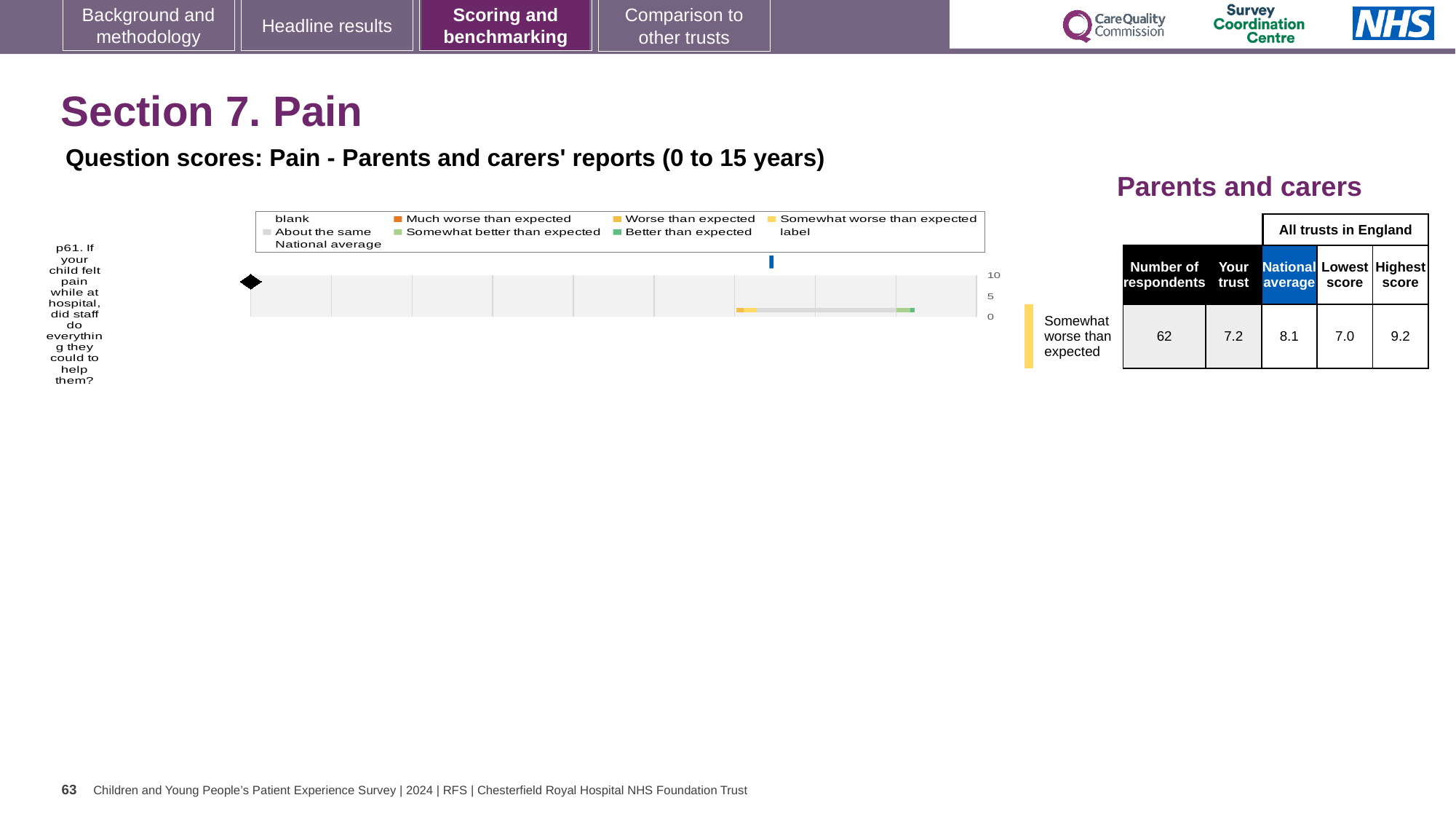
Which benchmark category does the trust's score for p61 fall into, according to the label beside the table? Somewhat worse than expected What is the difference between the Highest score and the Lowest score for p61? 2.2 How many survey questions are plotted in the chart? 1 What is the difference between the National average and the Your trust score for p61? 0.9 In the Parents and carers table, how many respondents answered question p61? 62 What kind of chart is shown on the slide? bar chart Which is larger for p61: the Your trust score or the National average? National average In the Parents and carers table, what is the score for Your trust? 7.2 In the Parents and carers table, what is the National average score? 8.1 In the Parents and carers table, what is the Highest score among all trusts in England? 9.2 In the Parents and carers table, what is the Lowest score among all trusts in England? 7.0 Which survey question is plotted in the chart? p61. If your child felt pain while at hospital, did staff do everything they could to help them?